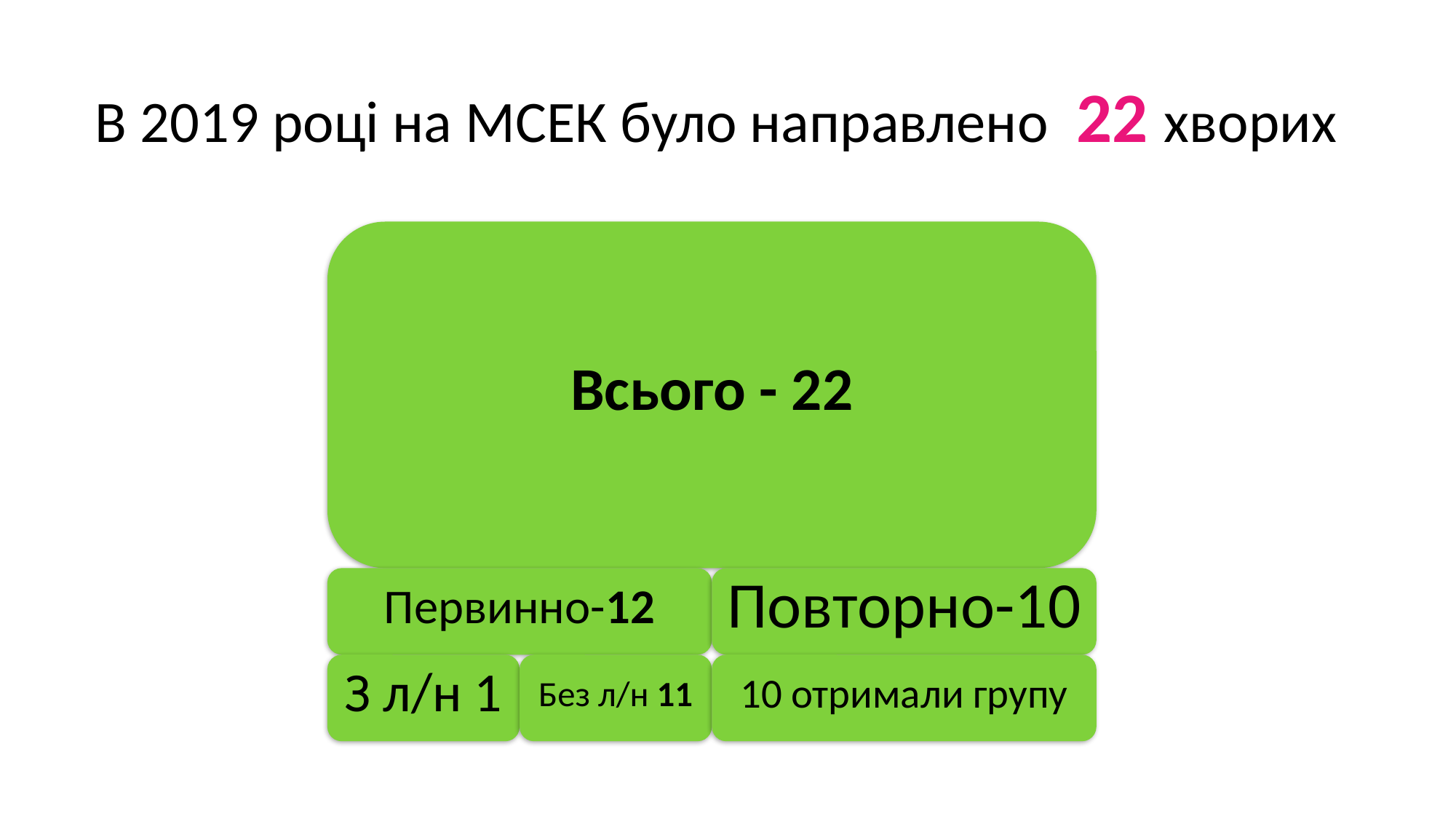
How many patients received a group ("отримали групу") according to the diagram? 10 How many patients are shown as "Первинно" (primary) in the diagram? 12 Which is larger in the diagram, "Первинно" or "Повторно"? Первинно How many patients are shown as "Повторно" (repeat) in the diagram? 10 What is the difference between the "Первинно" and "Повторно" values in the diagram? 2 What value is shown for "З л/н" in the diagram? 1 What year does the slide title say the patients were referred to МСЕК? 2019 Which of the two sub-boxes under "Первинно" has the smaller value? З л/н What total number is shown in the top box of the diagram? 22 What colour are the boxes of the diagram? Green What is the difference between the "Без л/н" and "З л/н" values in the diagram? 10 What value is shown for "Без л/н" in the diagram? 11